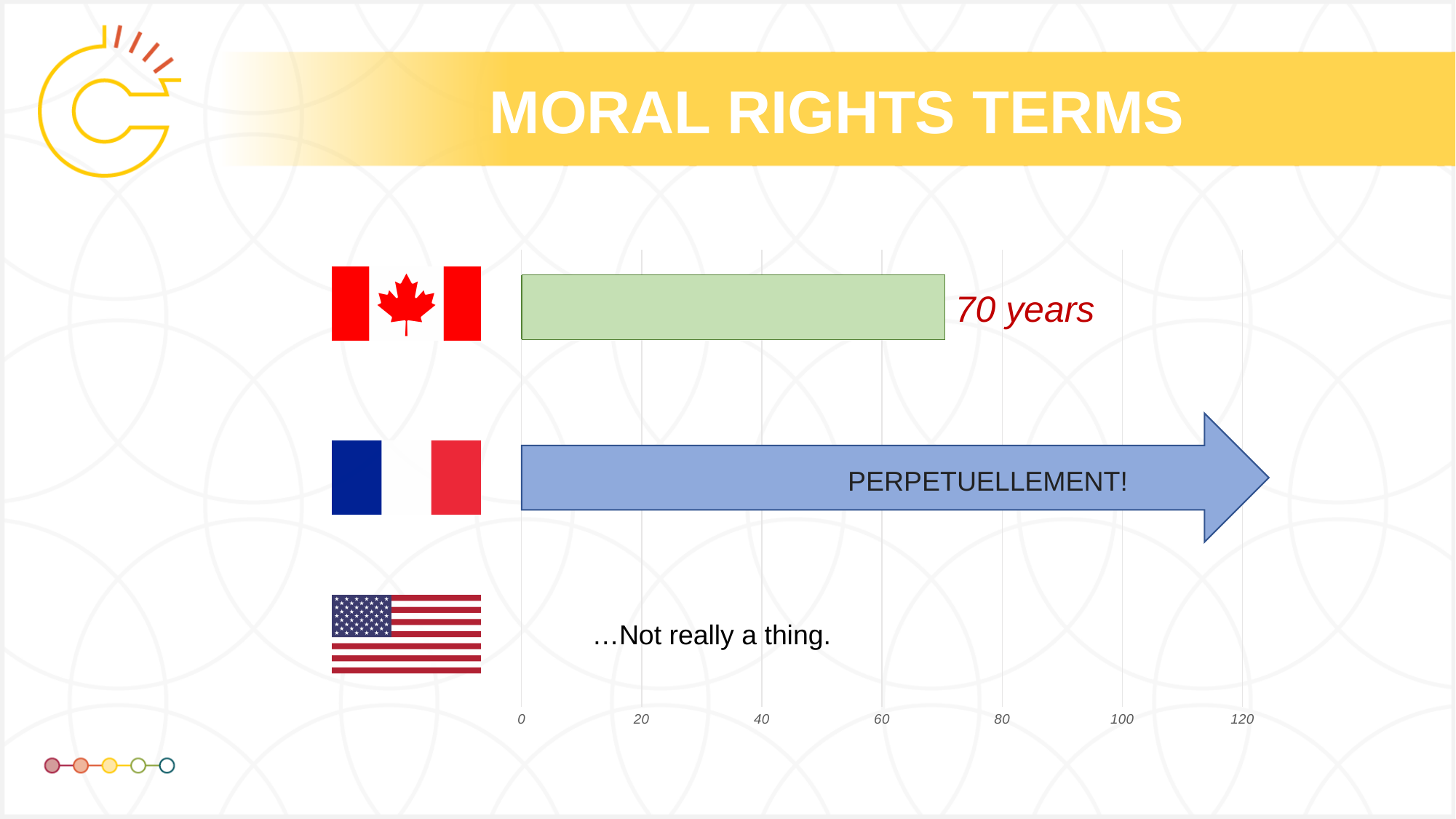
How many plotted bars does the chart contain? 1 How many tick labels are shown on the horizontal axis? 7 What is the lowest tick value shown on the horizontal axis? 0 Is the value of the bar next to the Canadian flag greater or less than 80? less Is the value of the bar next to the Canadian flag greater or less than 60? greater What is the interval between consecutive tick labels on the horizontal axis? 20 What is the title of the slide containing the chart? MORAL RIGHTS TERMS What is the highest tick value shown on the horizontal axis? 120 What kind of chart is shown on the slide? bar chart What text is written on the blue arrow next to the French flag? PERPETUELLEMENT! What is the moral rights term shown for Canada (the bar next to the Canadian flag)? 70 years